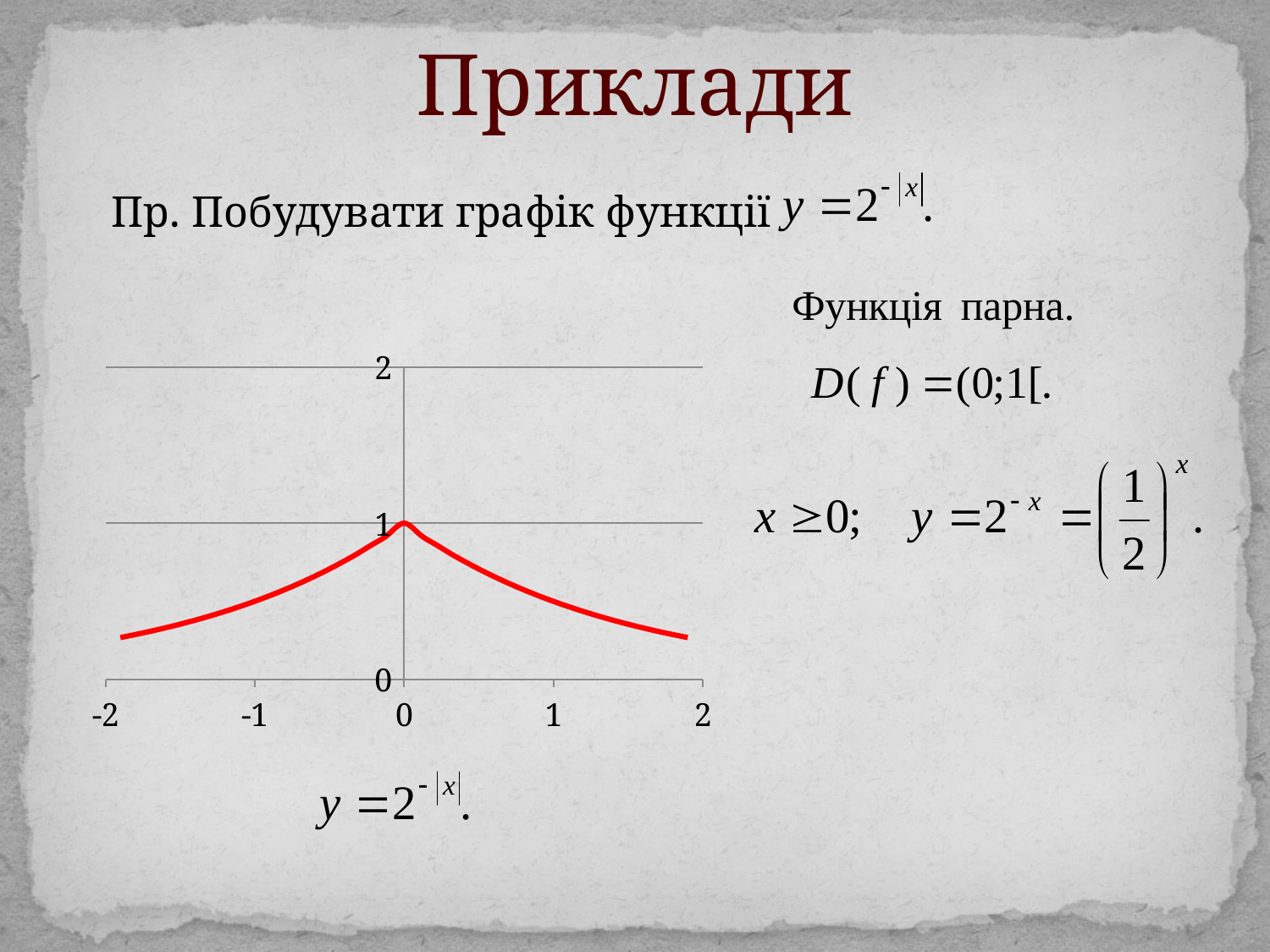
Which is larger, the value of the curve at x = 0 or at x = 1? x = 0 How many tick labels are shown on the x axis? 5 What is the value of the curve at x = 0? 1 What kind of chart is shown on the slide? line chart Is the value of the curve at x = 2 greater or less than 1? less Which is larger, the value of the curve at x = -1 or at x = -2? x = -1 Do the values rise or fall as x goes from 0 to 2? fall At which x value does the plotted curve reach its highest point? 0 Is the value of the curve at x = 1 greater or less than 1? less Is the value of the curve at x = -2 greater or less than 1? less Do the values rise or fall as x goes from -2 to 0? rise What colour is the plotted curve? red